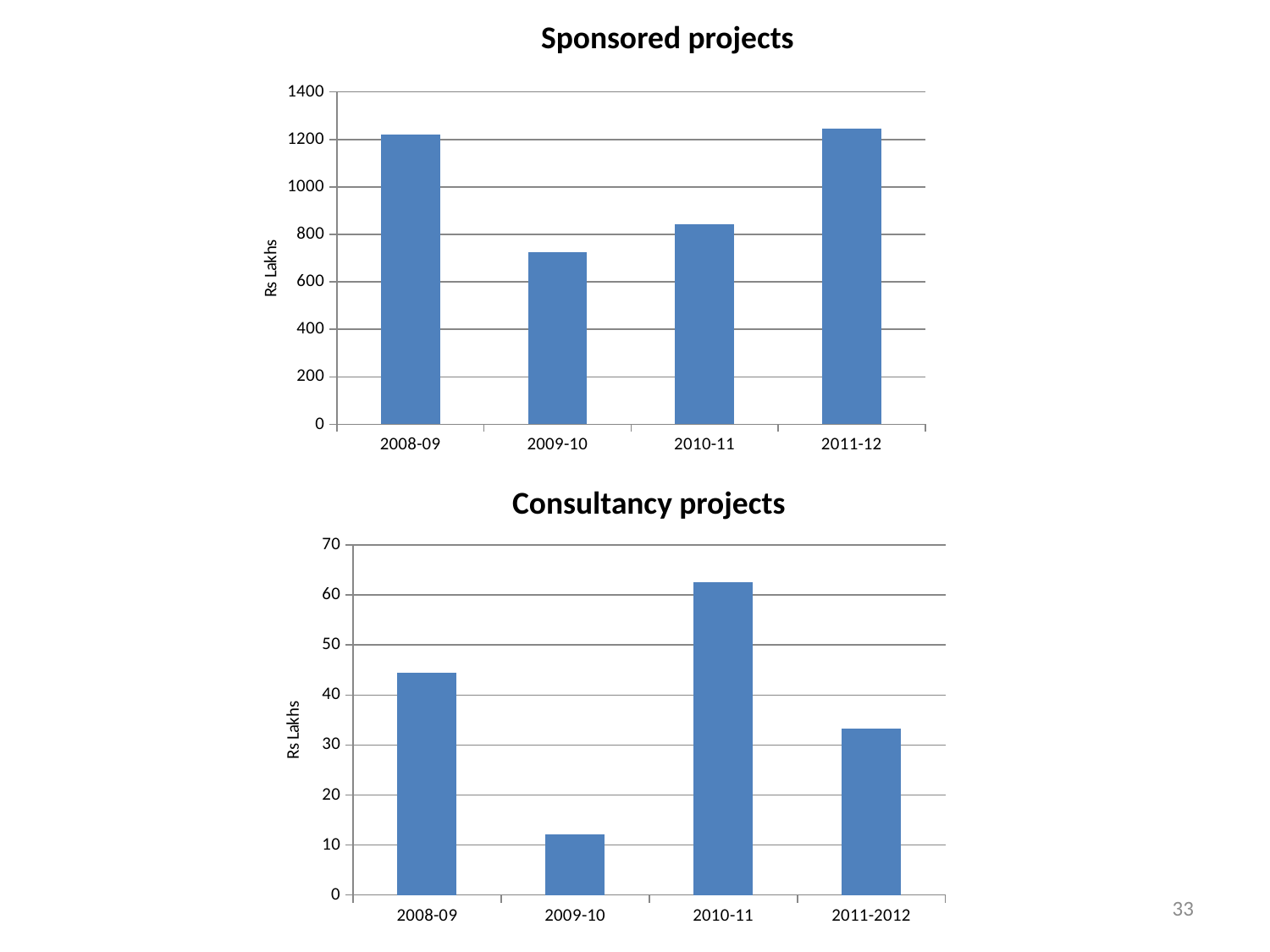
In the Sponsored projects chart, which is larger, the value for 2008-09 or the value for 2010-11? 2008-09 In the Sponsored projects chart, which year has the lowest value? 2009-10 In the Consultancy projects chart, which is larger, the value for 2008-09 or the value for 2011-2012? 2008-09 How many years are shown in the Consultancy projects chart? 4 In the Sponsored projects chart, is the value for 2009-10 greater or less than 800? less What kind of chart is the Sponsored projects chart? Bar chart In the Consultancy projects chart, which year has the lowest value? 2009-10 In the Sponsored projects chart, is the value for 2010-11 greater or less than 800? greater In the Consultancy projects chart, is the value for 2011-2012 greater or less than 40? less In the Consultancy projects chart, which year has the highest value? 2010-11 What is the y-axis label of the Sponsored projects chart? Rs Lakhs